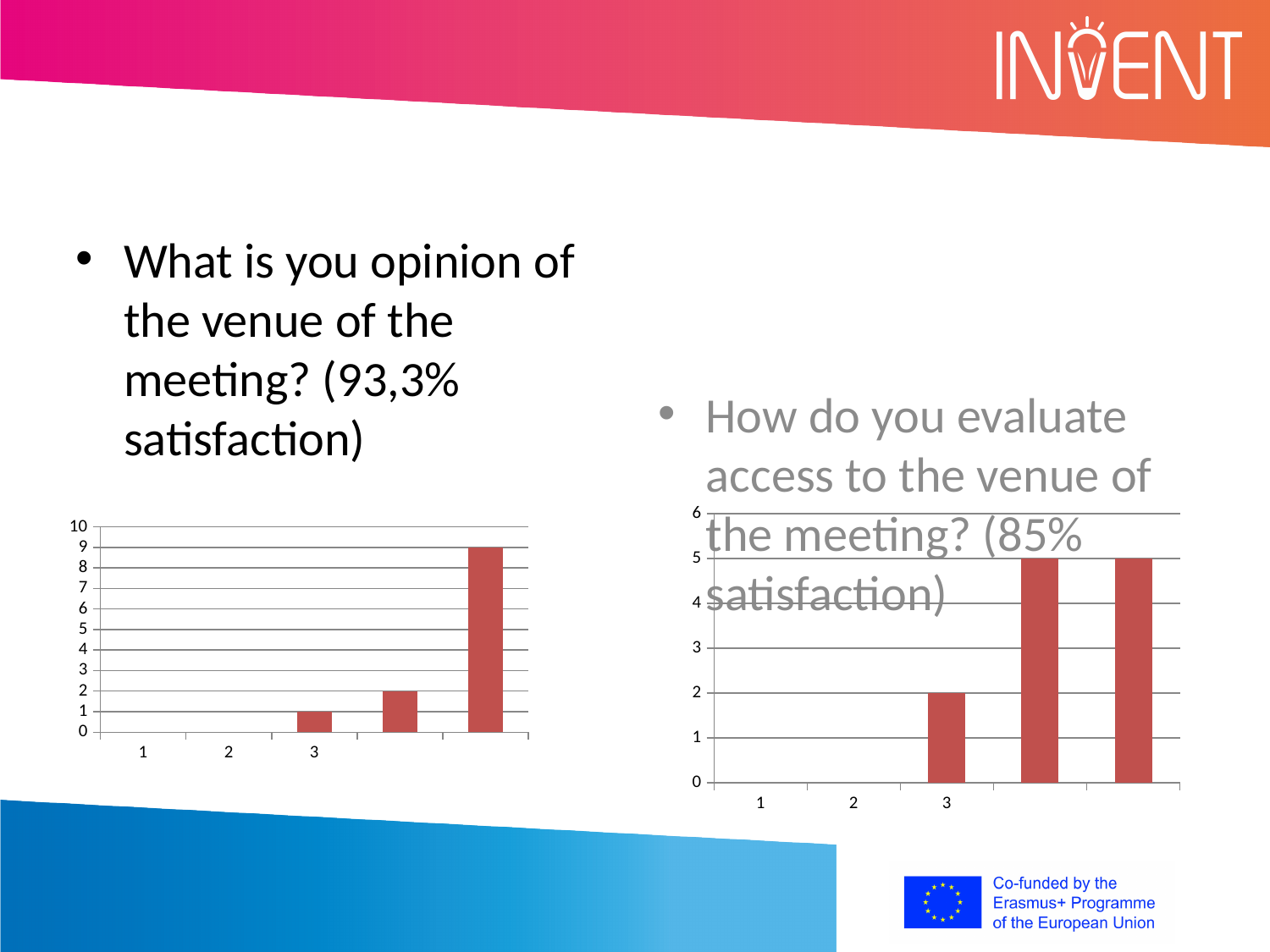
In the chart on the left of the slide, how many bars have a value above zero? 3 In the chart on the left of the slide, what is the value of the tallest bar? 9 In the chart on the right of the slide, what is the value for category 3? 2 In the chart on the right of the slide, what is the value of the tallest bars? 5 In the chart on the left of the slide, do the bar values rise or fall from left to right? rise In the chart on the left of the slide, what is the value for category 3? 1 In the chart on the left of the slide, what is the highest value shown on the vertical axis? 10 In the chart on the right of the slide, what is the difference between the tallest bar and the bar for category 3? 3 In the chart on the right of the slide, how many bars have a value above zero? 3 What kind of chart is the chart on the left of the slide? bar chart In the chart on the left of the slide, what is the difference between the tallest bar and the bar for category 3? 8 In the chart on the left of the slide, is the value of the tallest bar greater or less than 5? greater